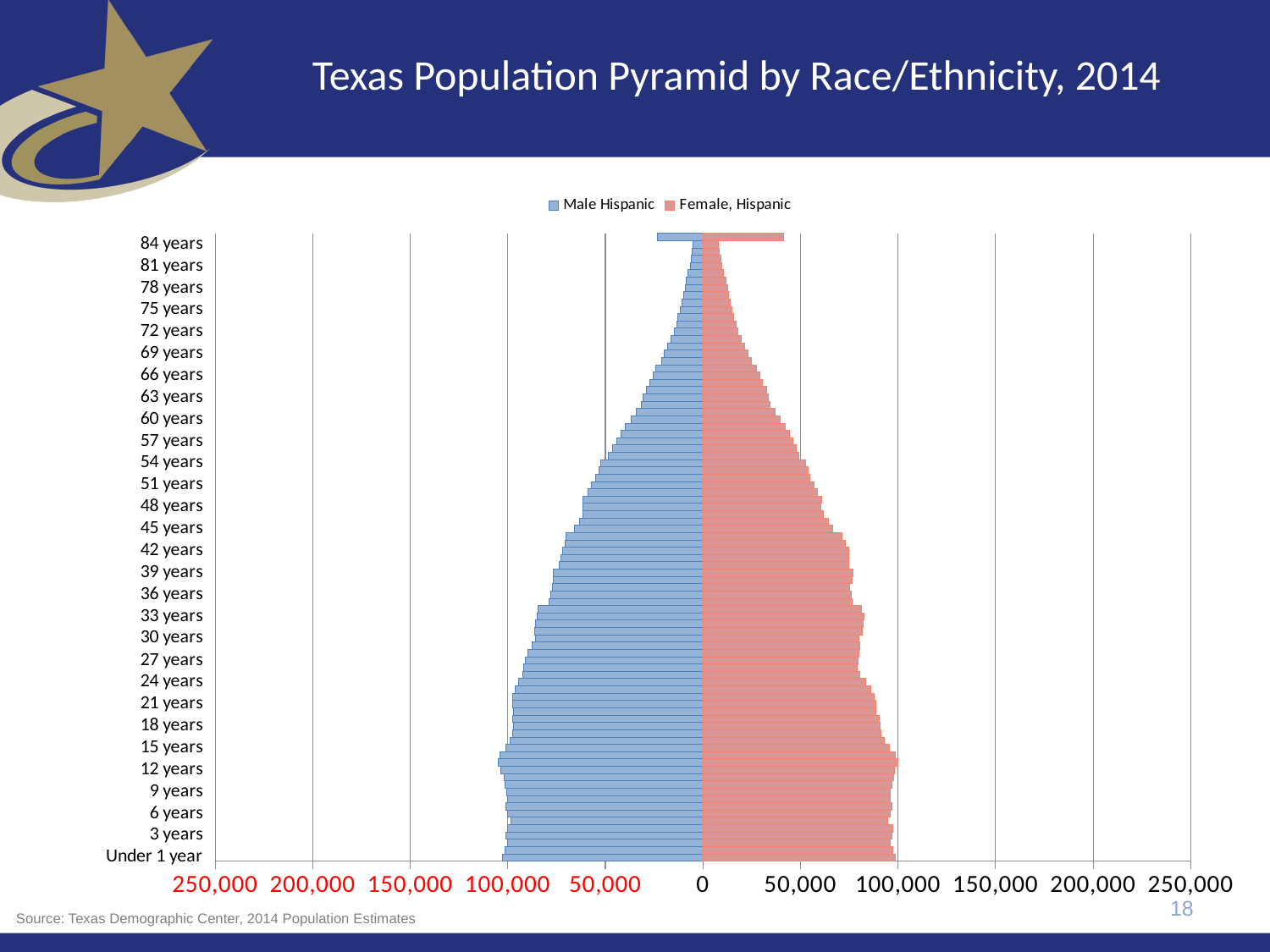
Which is larger for Female, Hispanic: the value for 15 years or the value for 66 years? 15 years What is the title of the chart? Texas Population Pyramid by Race/Ethnicity, 2014 Is the Male Hispanic value for 30 years greater or less than 100,000? less Which is larger for Male Hispanic: the value for 12 years or the value for 84 years? 12 years How many series does the legend list? 2 Is the Male Hispanic value for 84 years greater or less than 50,000? less Is the Female, Hispanic value for 45 years greater or less than 50,000? greater What are the two series named in the legend? Male Hispanic and Female, Hispanic Do the Male Hispanic bars generally get longer or shorter as age increases from Under 1 year to 84 years? shorter What kind of chart is shown on the slide? Bar chart